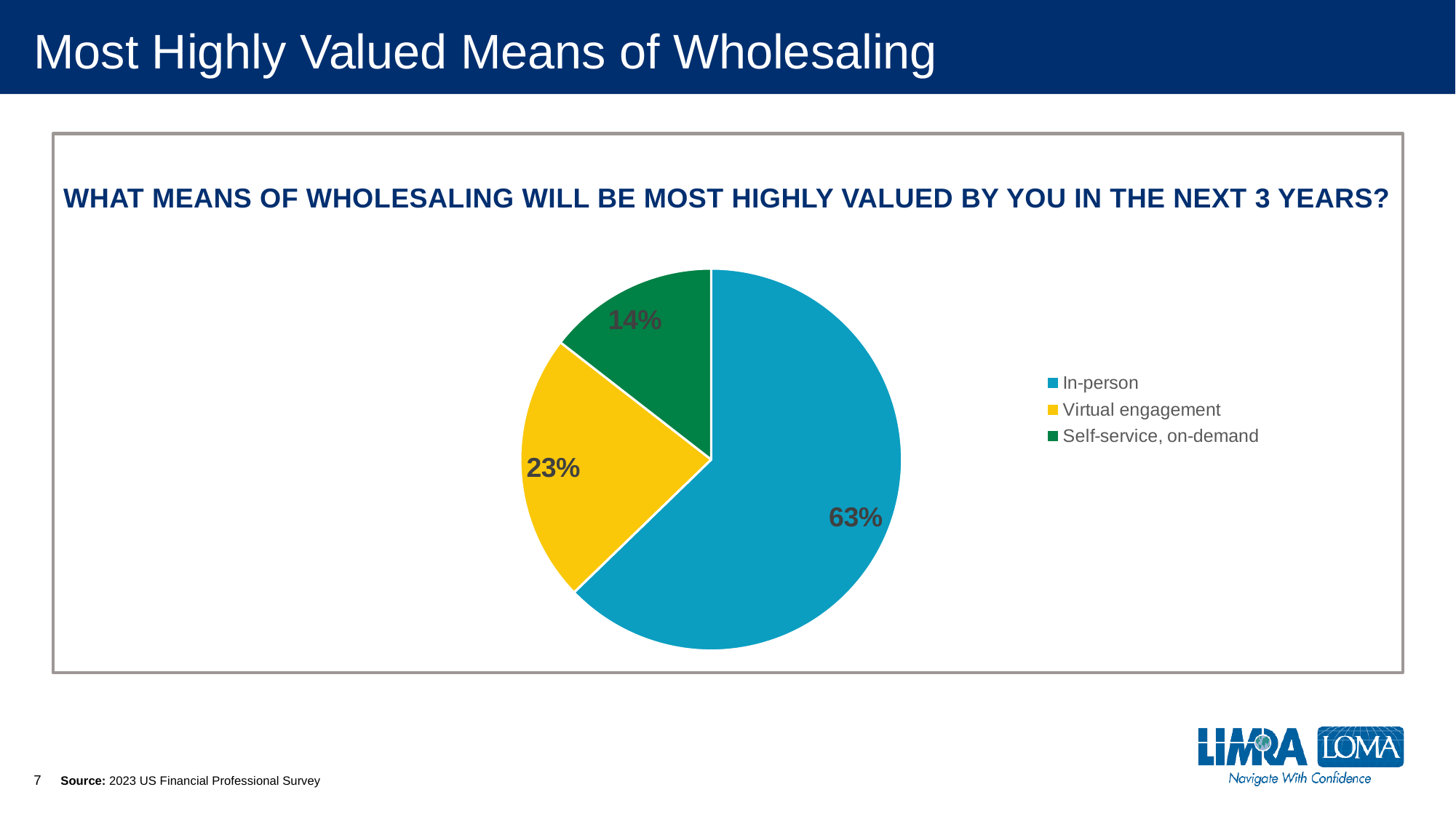
How many slices does the pie chart have? 3 Which means of wholesaling has the smallest share of the pie? Self-service, on-demand Which means of wholesaling has the largest share of the pie? In-person What share of the pie is Self-service, on-demand? 14% What kind of chart is shown on the slide? pie chart Which is larger, the share for Virtual engagement or the share for Self-service, on-demand? Virtual engagement How many entries does the legend list? 3 What share of the pie is Virtual engagement? 23% What is the difference in percentage points between In-person and Virtual engagement? 40 What share of the pie is In-person? 63% What is the difference in percentage points between Virtual engagement and Self-service, on-demand? 9 What colour is the In-person slice of the pie? blue